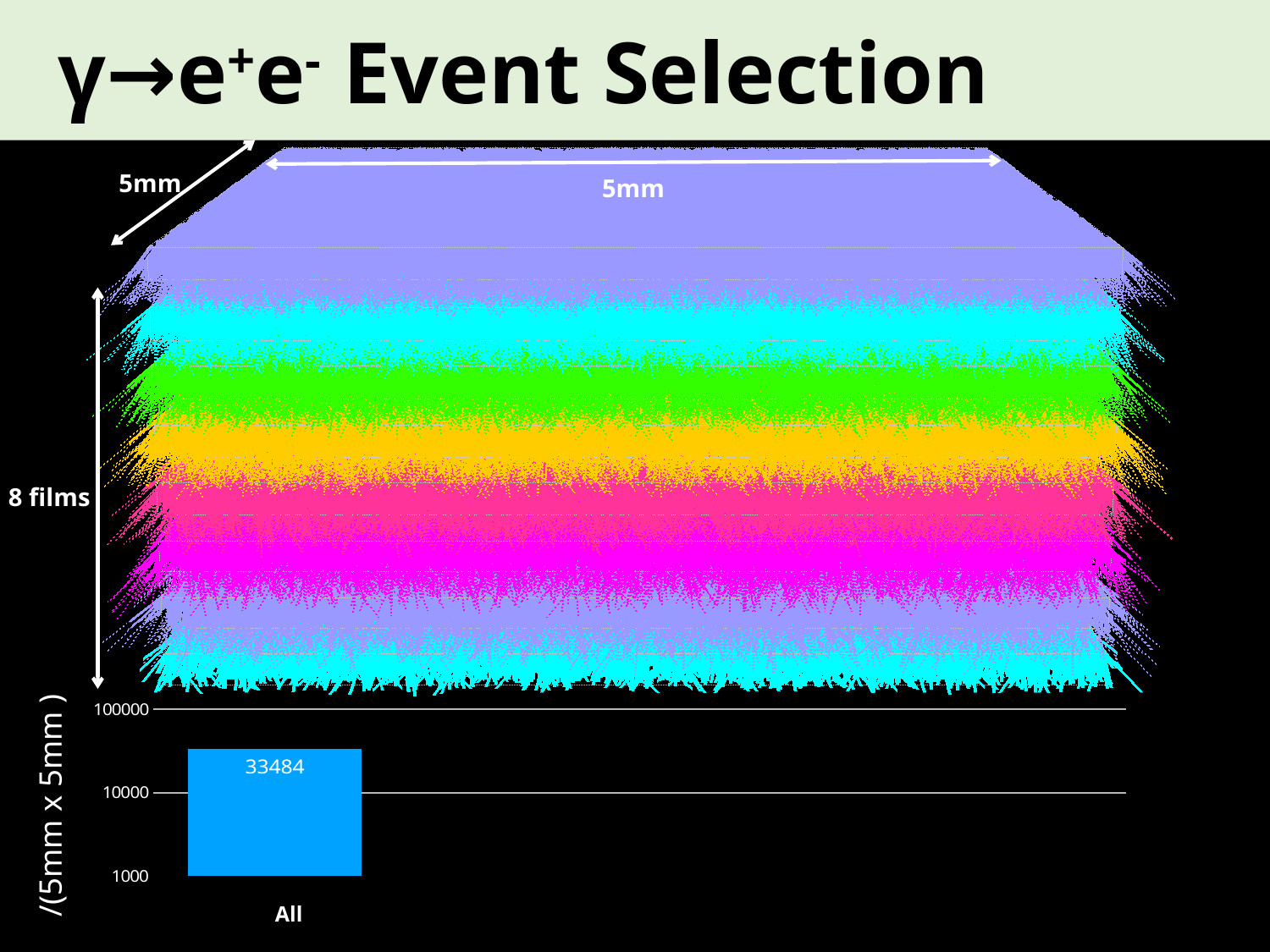
In the bar chart at the bottom of the slide, is the value for "All" greater or less than 100000? less What is the label on the vertical axis of the bar chart at the bottom of the slide? /(5mm x 5mm ) What kind of chart is shown at the bottom of the slide? bar chart What is the lowest tick value shown on the vertical axis of the bar chart at the bottom of the slide? 1000 How many bars are plotted in the bar chart at the bottom of the slide? 1 In the bar chart at the bottom of the slide, is the value for "All" greater or less than 10000? greater What is the category label under the single bar in the bar chart at the bottom of the slide? All What is the value of the bar labelled "All" in the bar chart at the bottom of the slide? 33484 What is the highest tick value shown on the vertical axis of the bar chart at the bottom of the slide? 100000